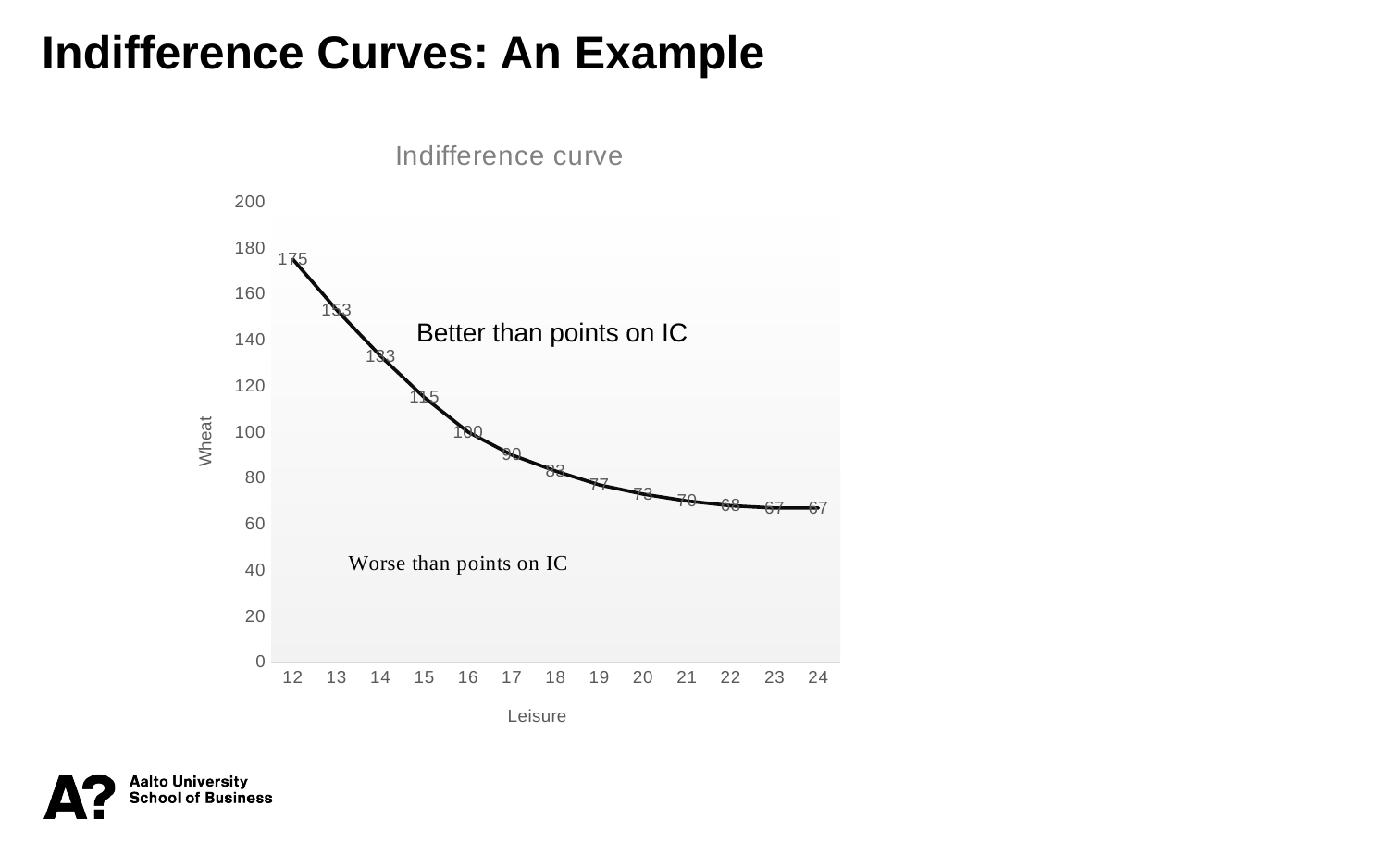
What is the value of Wheat when Leisure is 12? 175 Is the Wheat value at Leisure 20 greater or less than 80? less At which Leisure value is Wheat highest? 12 What is the label of the y axis? Wheat What is the title of the chart? Indifference curve What is the value of Wheat when Leisure is 15? 115 What is the value of Wheat when Leisure is 16? 100 What is the value of Wheat when Leisure is 24? 67 Which has a larger Wheat value, Leisure 12 or Leisure 24? Leisure 12 What type of chart is shown on the slide? line chart What is the difference between the Wheat value at Leisure 12 and at Leisure 24? 108 Do the Wheat values rise or fall as Leisure increases along the x axis? fall